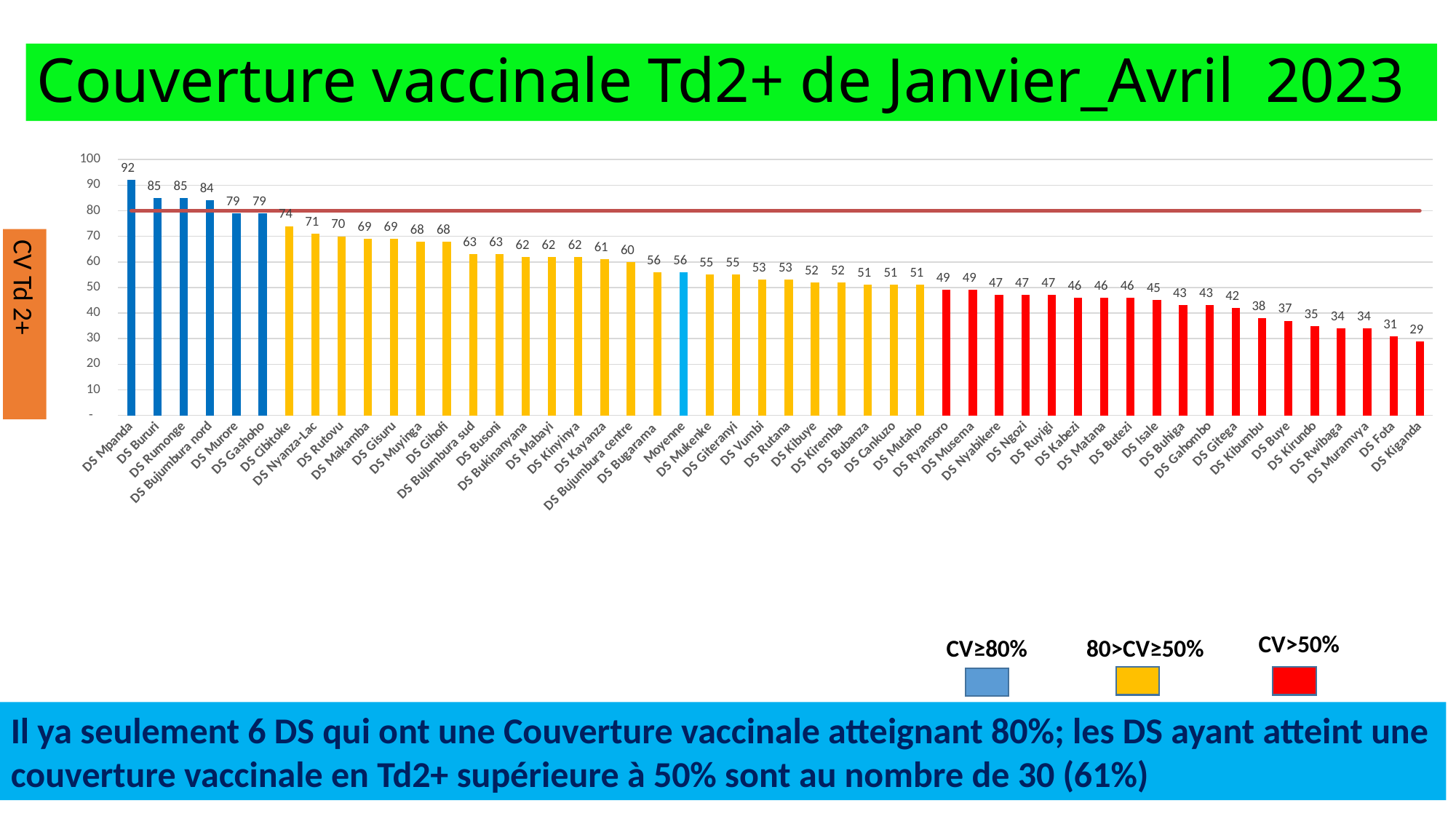
What is the difference between the values for DS Gashoho and DS Cibitoke? 5 What colour are the bars for categories with CV≥80%? Blue Which category has the lowest value? DS Kiganda What is the difference between the values for DS Mpanda and DS Kiganda? 63 What is the value shown for Moyenne? 56 What is the value for DS Mpanda? 92 Which category has the highest value? DS Mpanda Do the values rise or fall from left to right along the x axis? Fall Which is larger, the value for DS Bururi or the value for DS Murore? DS Bururi What kind of chart is shown on the slide? Bar chart What is the value for DS Cibitoke? 74 What is the value for DS Kiganda? 29